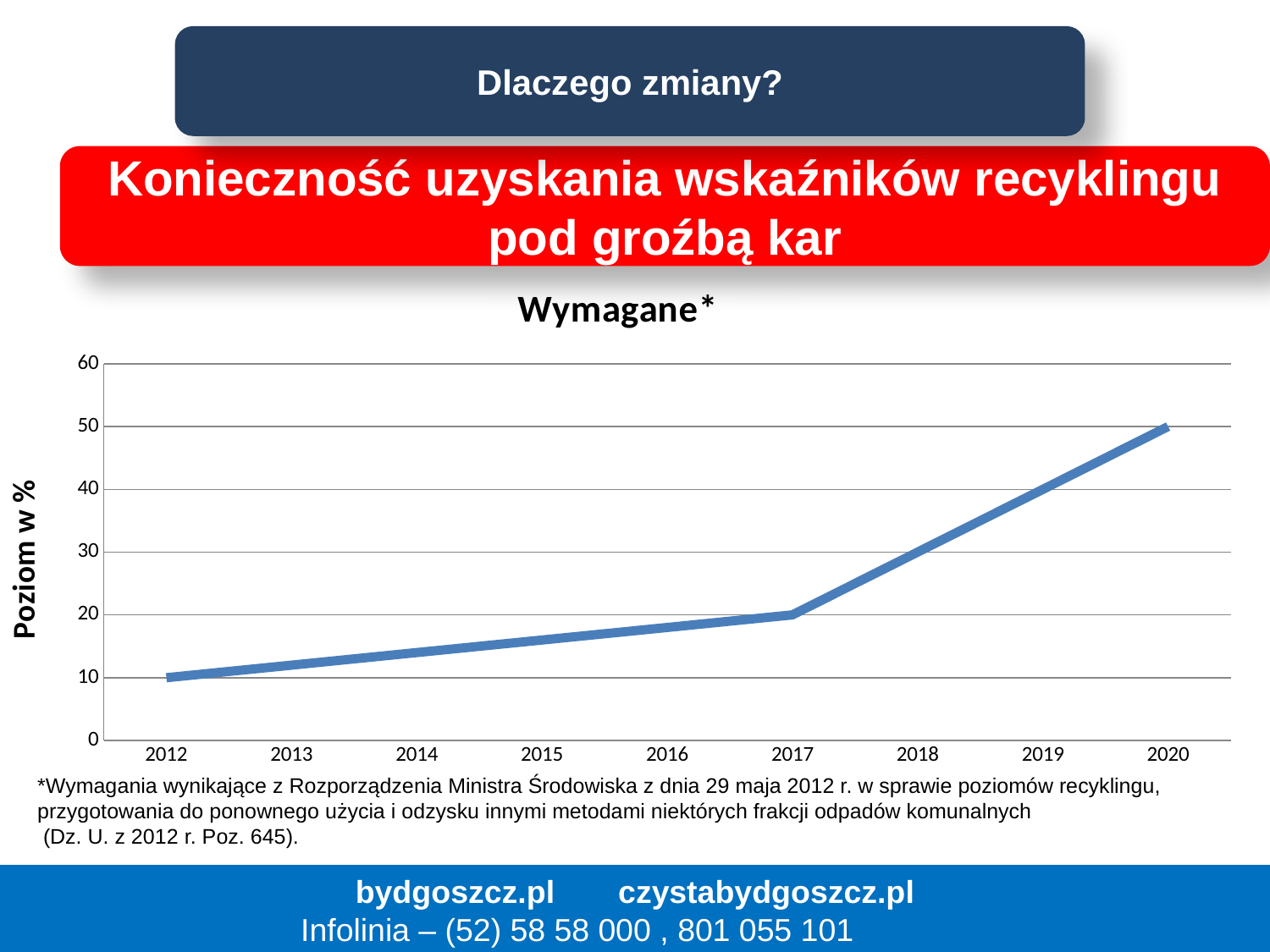
What is the value for 2017? 20 Which year has the highest value? 2020 Do the values rise or fall from 2012 to 2020? rise What is the difference between the values for 2020 and 2017? 30 What is the label of the vertical axis? Poziom w % What kind of chart is shown on the slide? line chart How many years are shown on the x axis of the chart? 9 Which year has the lowest value? 2012 Is the value for 2019 greater or less than 30? greater What is the value for 2012? 10 What is the title of the chart? Wymagane* What is the value for 2020? 50